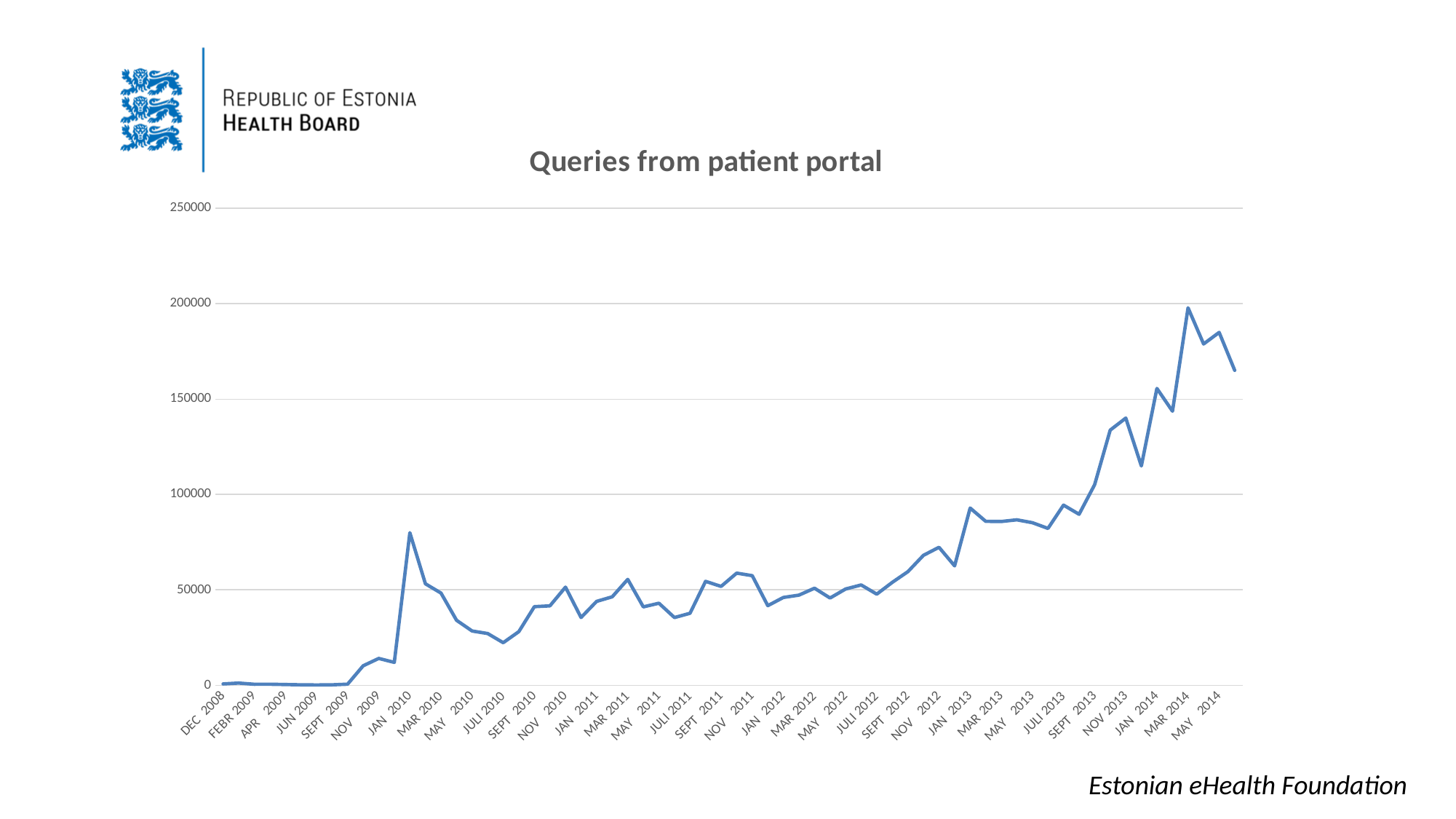
Which is larger, the value for MAY 2014 or the value for MAY 2010? MAY 2014 Is the value for MAY 2014 greater or less than 150000? greater How many lines (data series) are plotted on the chart? 1 What is the title of the chart? Queries from patient portal Is the value for DEC 2008 greater or less than 50000? less Is the value for NOV 2013 greater or less than 100000? greater Which is larger, the value for JAN 2013 or the value for JAN 2011? JAN 2013 What is the highest value shown on the vertical axis? 250000 What kind of chart is shown on the slide? line chart Overall, do the values rise or fall from DEC 2008 to MAY 2014? rise